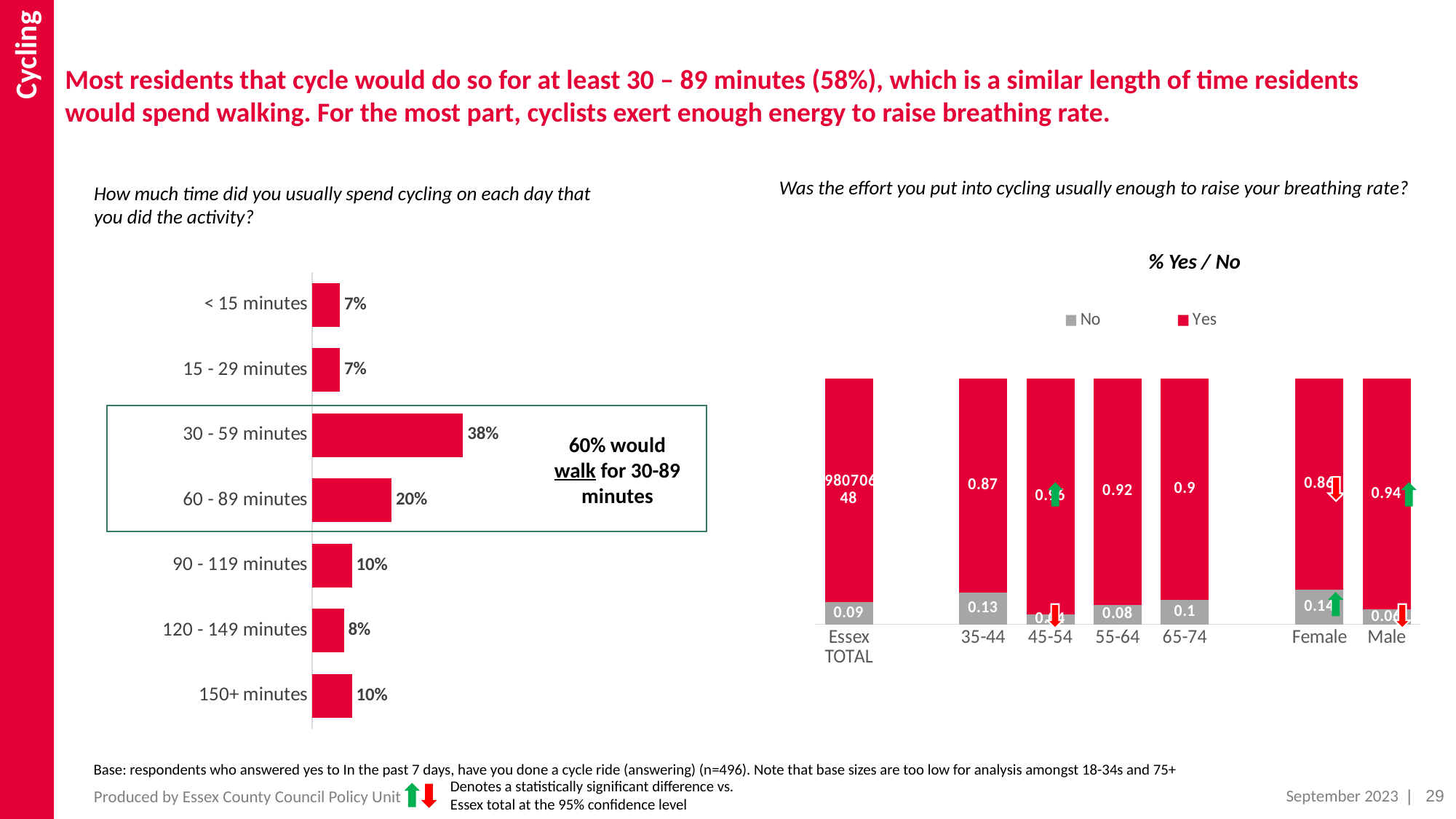
In the right chart (% Yes / No), what is the No value for Female? 0.14 What kind of chart is the left chart on how much time residents spend cycling? Bar chart In the right chart (% Yes / No), what is the Yes value for 55-64? 0.92 In the left chart on how much time residents spend cycling, which category has the highest percentage? 30 - 59 minutes In the right chart (% Yes / No), what is the Yes value for 35-44? 0.87 In the right chart (% Yes / No), how many series does the legend list? 2 In the left chart on how much time residents spend cycling, what percentage is shown for 60 - 89 minutes? 20% In the left chart on how much time residents spend cycling, what percentage is shown for 30 - 59 minutes? 38% In the right chart (% Yes / No), which colour represents the Yes series? Red In the left chart on how much time residents spend cycling, how many time categories are shown? 7 In the left chart on how much time residents spend cycling, what is the difference between the 30 - 59 minutes and 60 - 89 minutes values? 18 percentage points In the left chart on how much time residents spend cycling, which is larger: 90 - 119 minutes or 120 - 149 minutes? 90 - 119 minutes